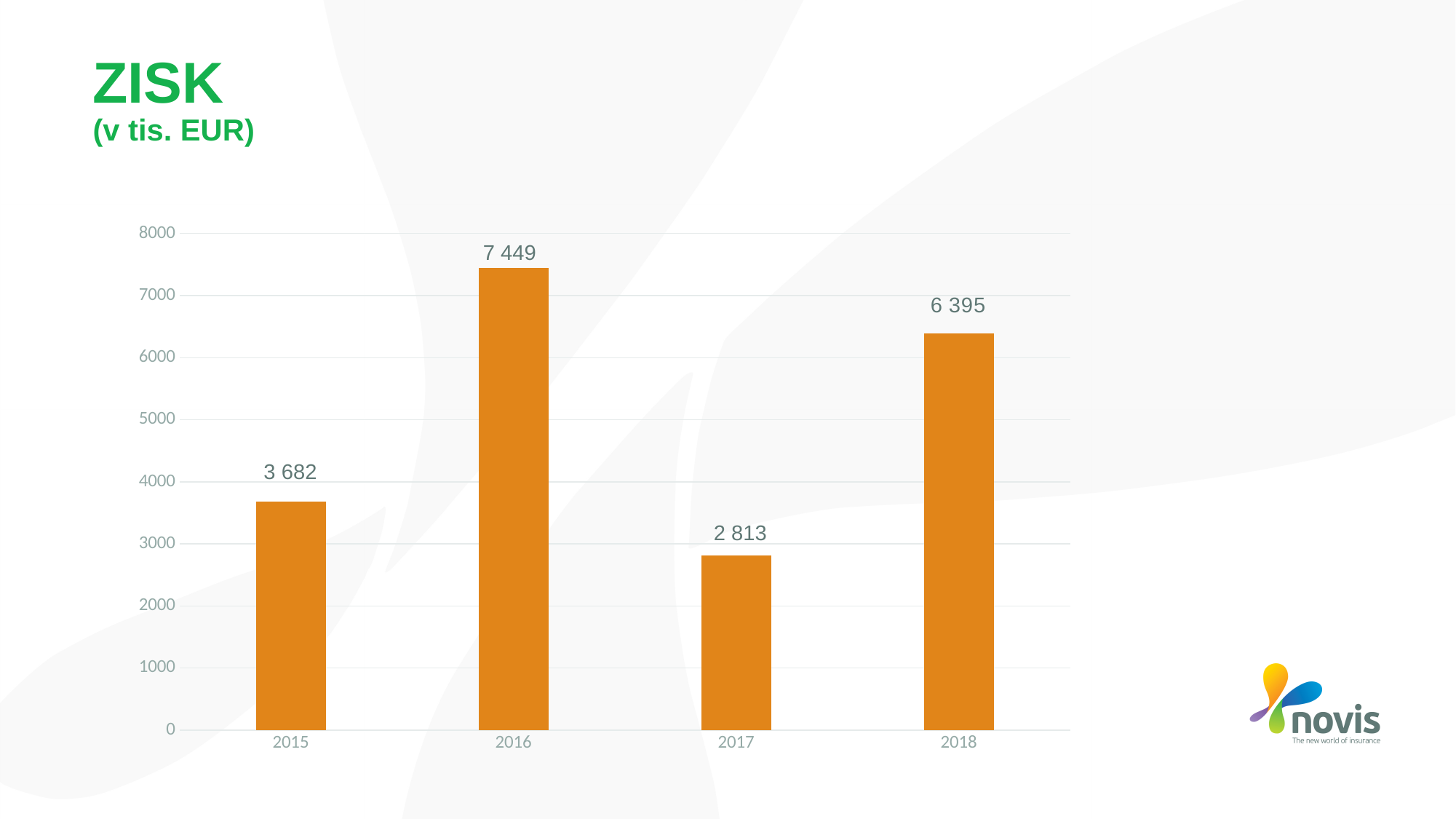
What is the difference between the values for 2015 and 2017? 869 What is the value for 2018? 6 395 What is the value for 2016? 7 449 What is the title of the chart? ZISK (v tis. EUR) What is the value for 2015? 3 682 How many years are shown on the x axis? 4 Which year has the highest value? 2016 What is the difference between the values for 2016 and 2018? 1 054 Which is larger, the value for 2015 or the value for 2018? 2018 What kind of chart is shown on the slide? bar chart What is the value for 2017? 2 813 Which year has the lowest value? 2017